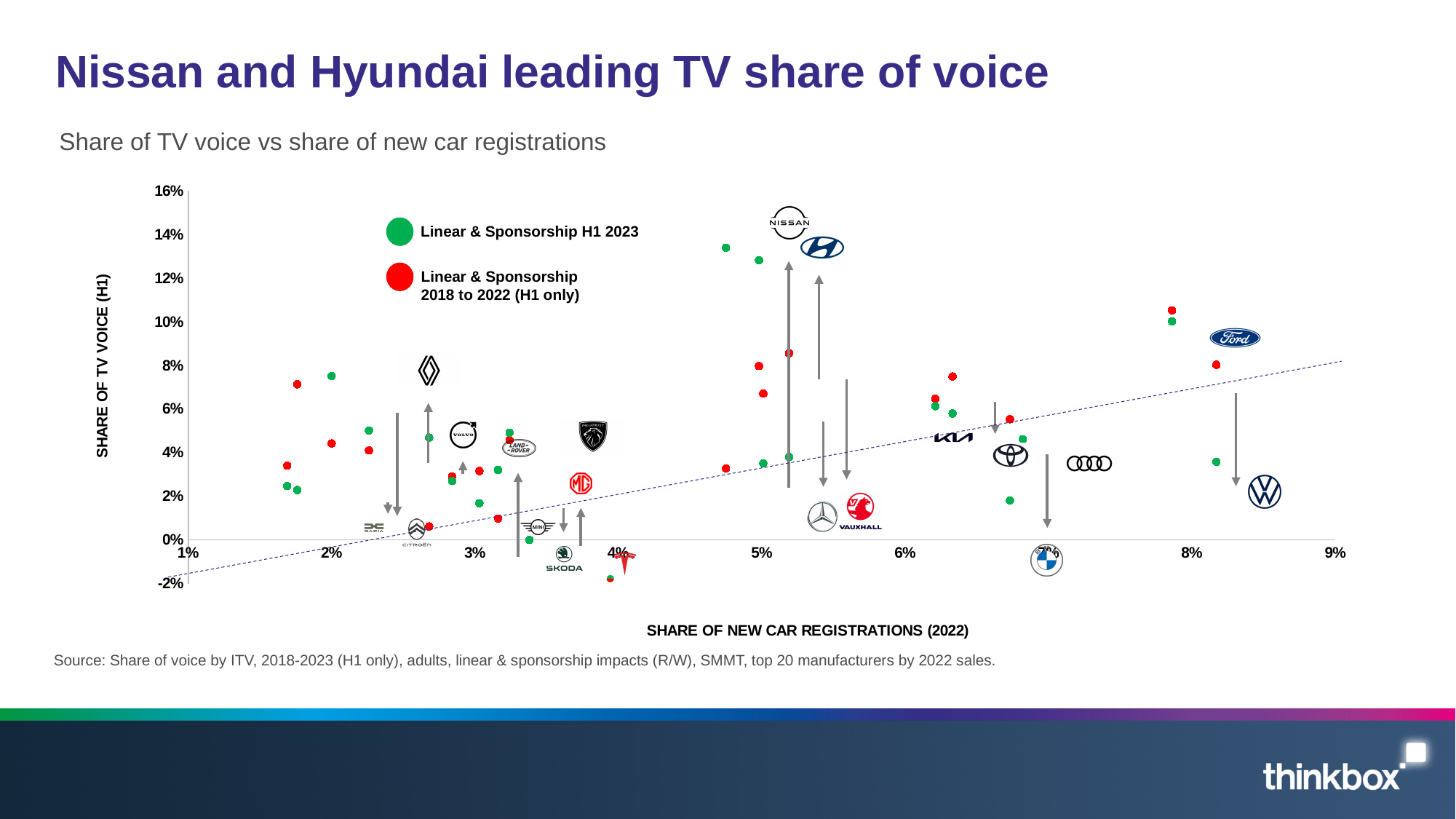
What kind of chart is shown on the slide? Scatter chart Is the green point near the Ford logo greater or less than 8% share of TV voice? greater Is the green point near the Nissan logo greater or less than 10% share of TV voice? greater Is the highest green point on the chart greater or less than 12% share of TV voice? greater How many series does the chart legend list? 2 Which series is shown in green in the chart legend? Linear & Sponsorship H1 2023 Which series contains the point with the highest share of TV voice on the chart? Linear & Sponsorship H1 2023 Does the dashed trend line on the chart rise or fall as share of new car registrations increases? Rises What is the title of the chart's horizontal axis? SHARE OF NEW CAR REGISTRATIONS (2022)